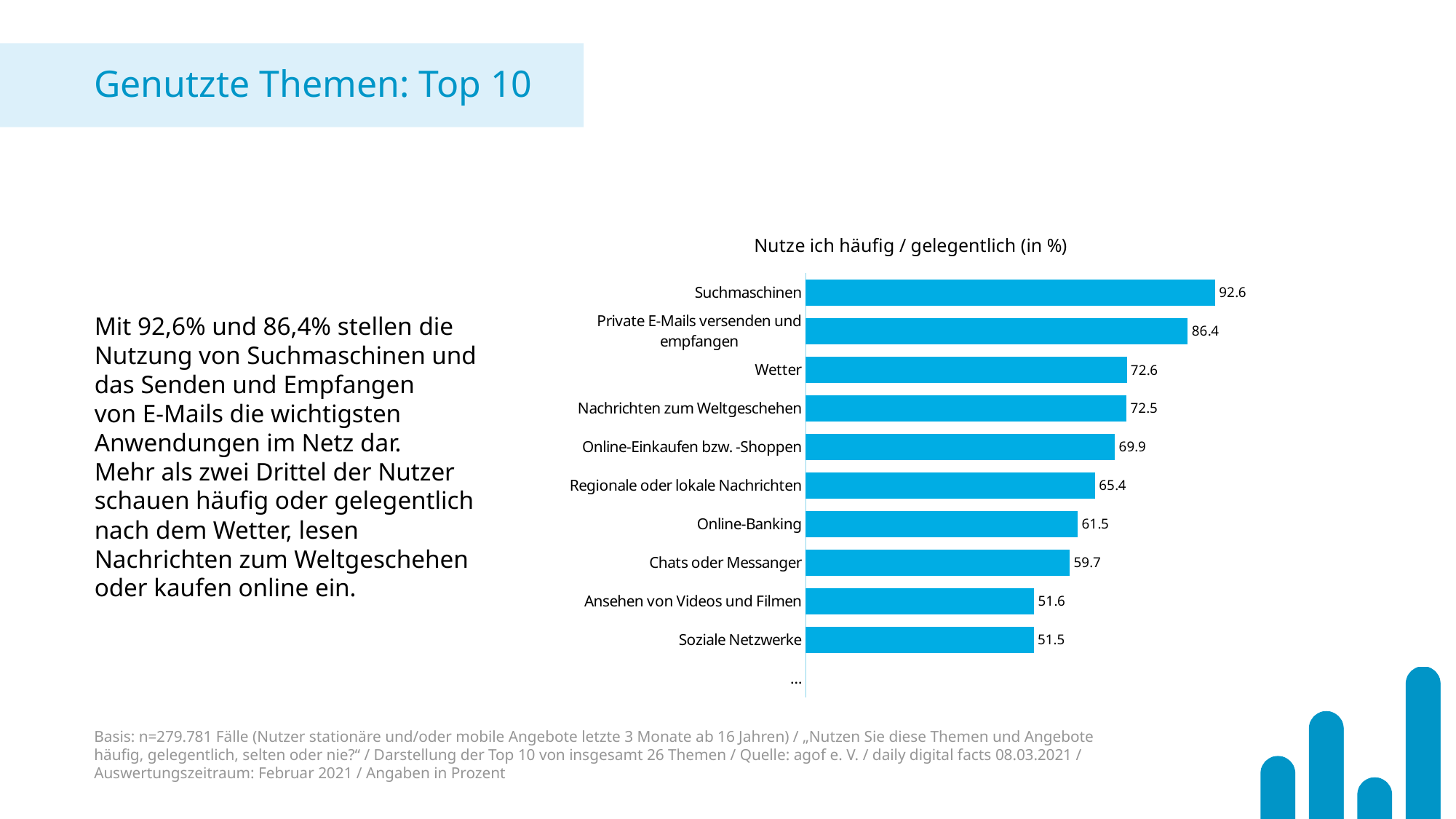
Which is larger, the value for Wetter or the value for Online-Banking? Wetter What is the value for Online-Banking? 61.5 What is the value for Suchmaschinen? 92.6 What is the difference between the values for Online-Einkaufen bzw. -Shoppen and Chats oder Messanger? 10.2 What kind of chart is shown on the slide? Bar chart What is the value for Ansehen von Videos und Filmen? 51.6 What is the difference between the values for Suchmaschinen and Private E-Mails versenden und empfangen? 6.2 Which category has the highest value? Suchmaschinen What is the title of the chart? Nutze ich häufig / gelegentlich (in %) How many categories with bars are shown in the chart? 10 What is the value for Regionale oder lokale Nachrichten? 65.4 Which category has the lowest value among the ten shown? Soziale Netzwerke